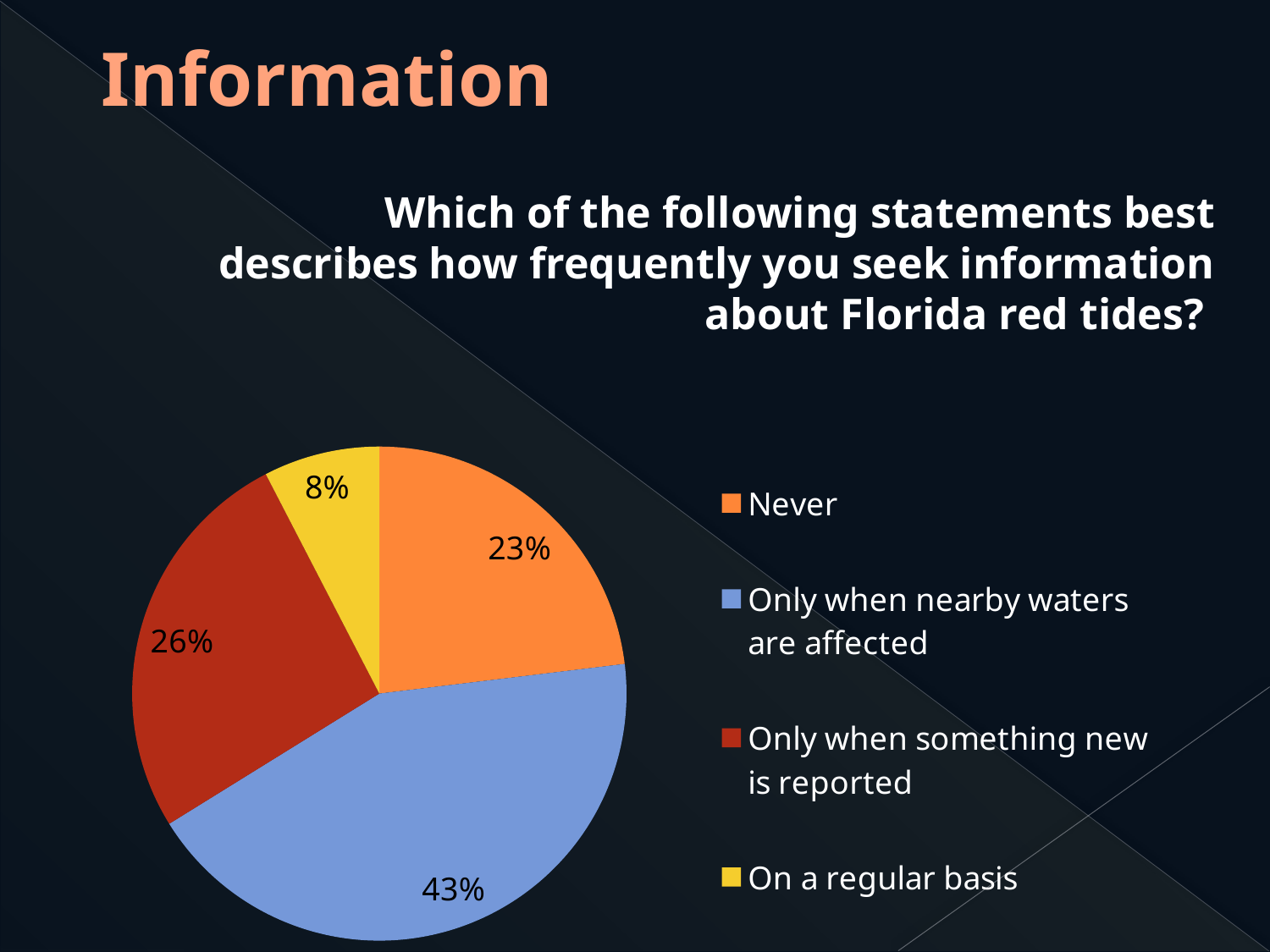
Which response has the smallest share of the pie? On a regular basis What kind of chart is shown on the slide? pie chart Which is larger: the share for "Only when something new is reported" or the share for "Never"? Only when something new is reported What share of respondents answered "Only when nearby waters are affected"? 43% What share of respondents answered "On a regular basis"? 8% What share of respondents answered "Never"? 23% Which response has the largest share of the pie? Only when nearby waters are affected How many entries does the legend list? 4 What is the difference in percentage points between "Only when nearby waters are affected" and "Never"? 20 What share of respondents answered "Only when something new is reported"? 26% How many slices does the pie chart have? 4 What colour is the slice for "On a regular basis"? yellow